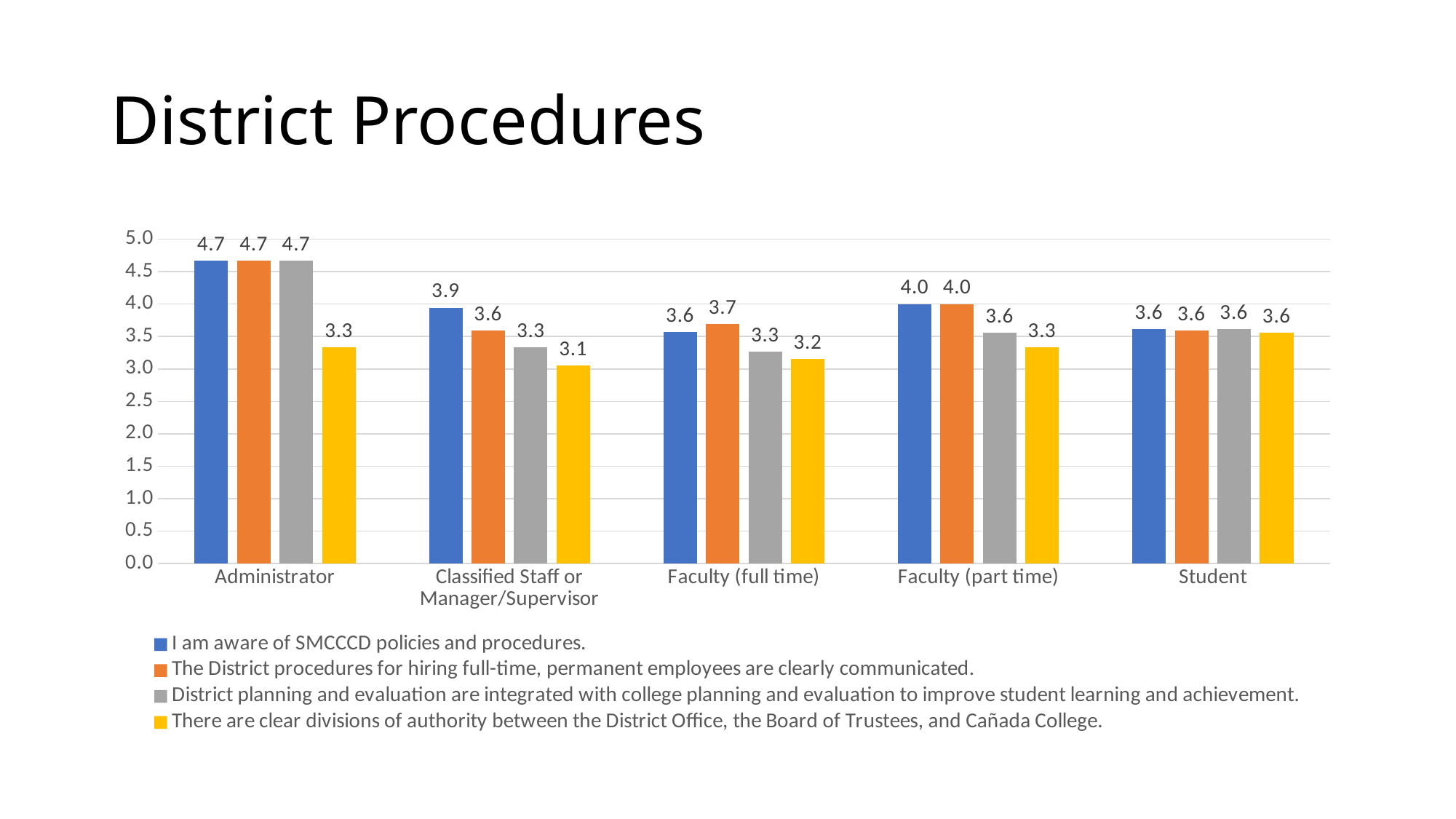
For Faculty (part time), which is larger: the value for "I am aware of SMCCCD policies and procedures." or the value for "There are clear divisions of authority between the District Office, the Board of Trustees, and Cañada College."? I am aware of SMCCCD policies and procedures. Is the value for Classified Staff or Manager/Supervisor for "I am aware of SMCCCD policies and procedures." greater or less than 3.5? greater What is the value for Administrator for "I am aware of SMCCCD policies and procedures."? 4.7 What is the value for Classified Staff or Manager/Supervisor for "There are clear divisions of authority between the District Office, the Board of Trustees, and Cañada College."? 3.1 How many respondent categories are shown on the x axis? 5 What is the difference between the Administrator value and the Student value for "I am aware of SMCCCD policies and procedures."? 1.1 What type of chart is shown on the slide? bar chart How many series does the legend list? 4 Which category has the lowest value for "There are clear divisions of authority between the District Office, the Board of Trustees, and Cañada College."? Classified Staff or Manager/Supervisor What is the value for Faculty (full time) for "The District procedures for hiring full-time, permanent employees are clearly communicated."? 3.7 Which category has the highest value for "District planning and evaluation are integrated with college planning and evaluation to improve student learning and achievement."? Administrator What is the title of the slide containing the chart? District Procedures